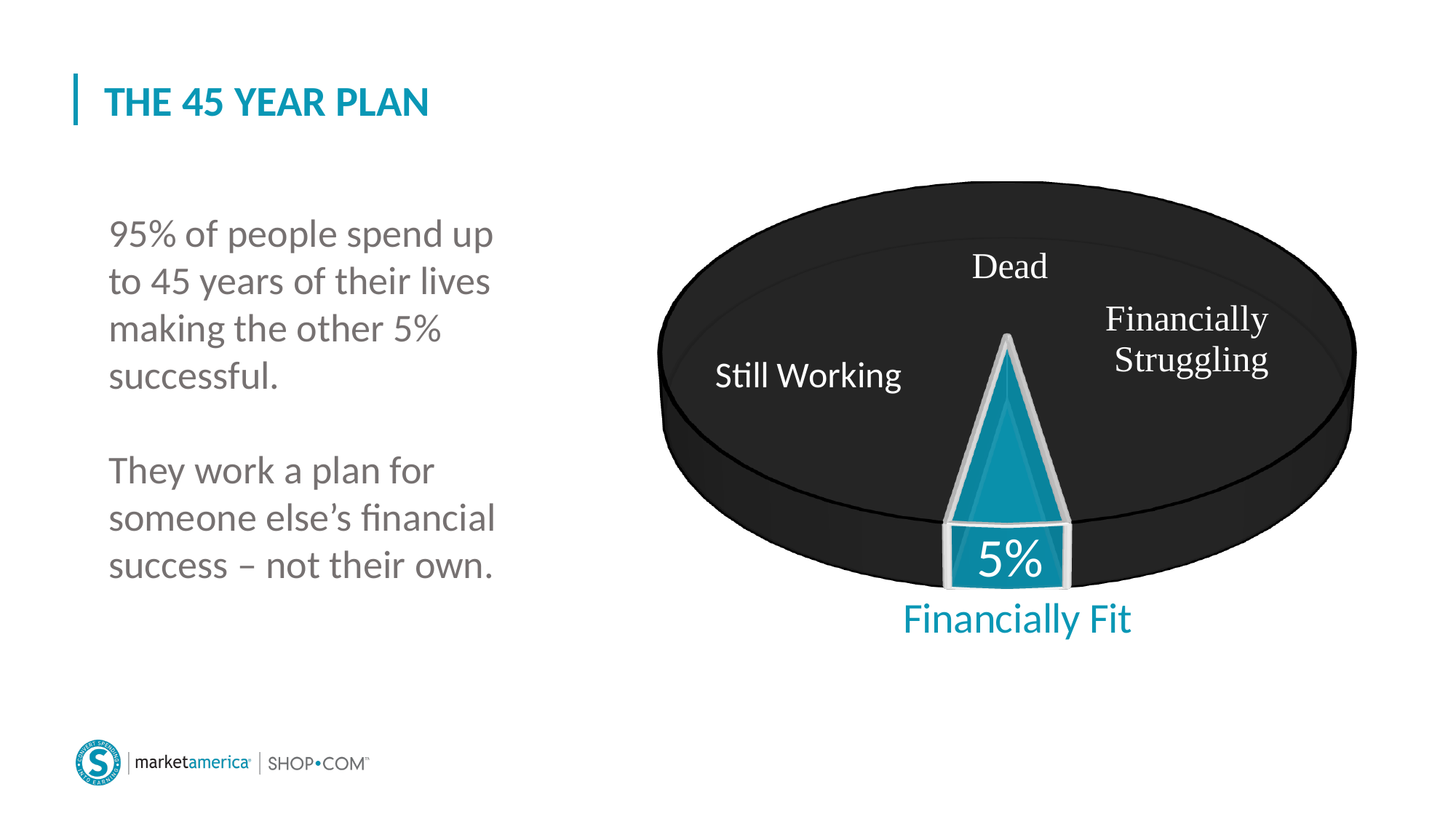
What share of the pie does the Financially Fit slice represent? 5% Which category is labelled on the highlighted (blue) slice of the pie chart? Financially Fit How many category labels appear on the pie chart? 4 What is the title of the slide containing the pie chart? THE 45 YEAR PLAN Which category has the smallest slice in the pie chart? Financially Fit What kind of chart is shown on the slide? pie chart What value is printed on the highlighted slice of the pie chart? 5% What colour is the Financially Fit slice of the pie chart? blue Is the Financially Fit slice larger or smaller than the rest of the pie combined? smaller